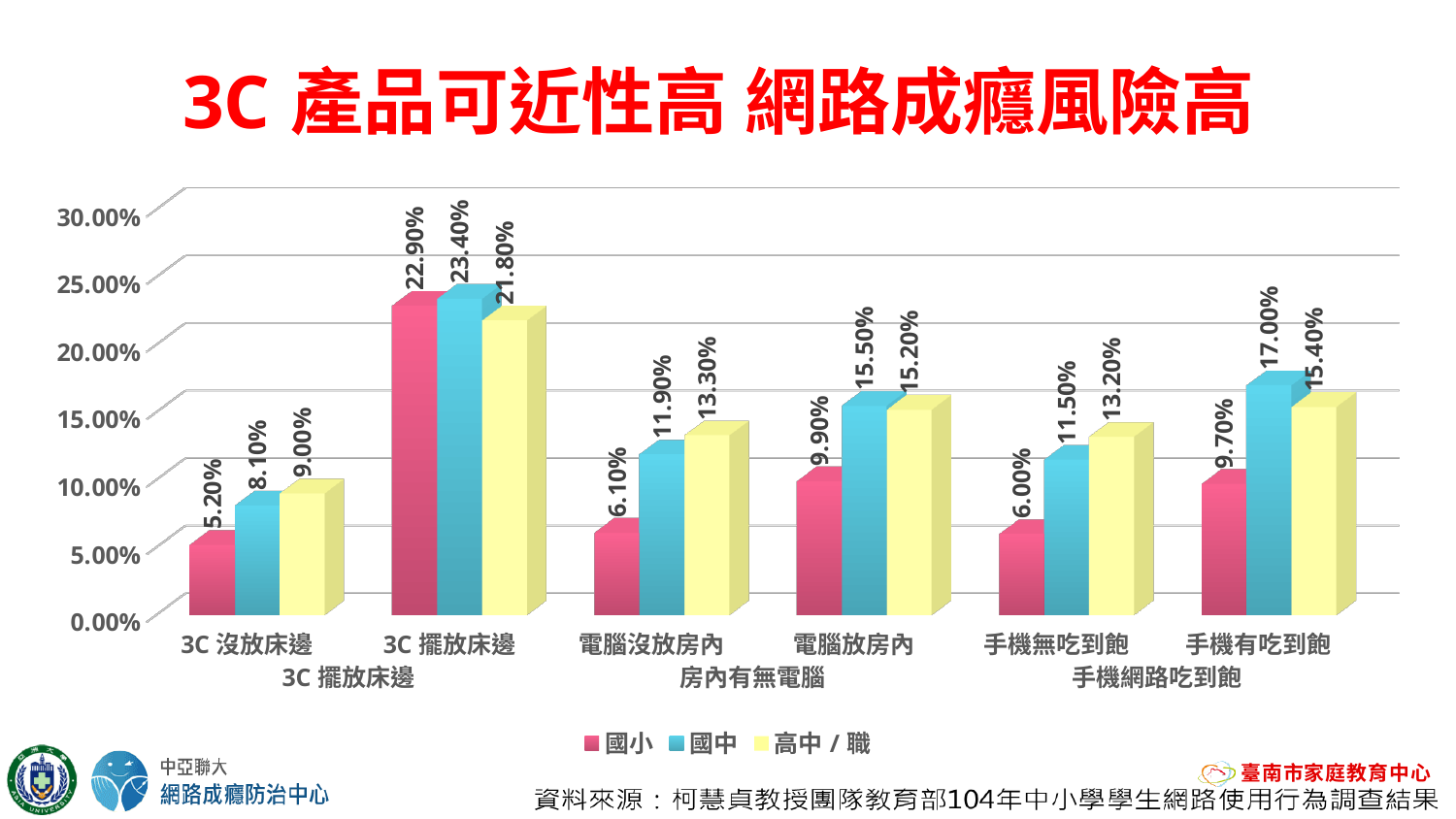
What is the value for 高中／職 in the 電腦沒放房內 category? 13.30% What is the difference between the 國中 and 國小 values in the 手機有吃到飽 category? 7.30% What kind of chart is shown on the slide? bar chart What is the value for 國中 in the 3C 擺放床邊 category? 23.40% Is the value for 國小 in the 3C 擺放床邊 category greater or less than 20.00%? greater Which category has the highest value for the 國小 series? 3C 擺放床邊 What is the value for 國小 in the 手機有吃到飽 category? 9.70% How many series does the legend list? 3 Which colour represents the 高中／職 series in the legend? yellow Which is larger in the 電腦放房內 category: the 國中 value or the 高中／職 value? 國中 How many categories are shown on the x axis? 6 Which category has the lowest value for the 國中 series? 3C 沒放床邊